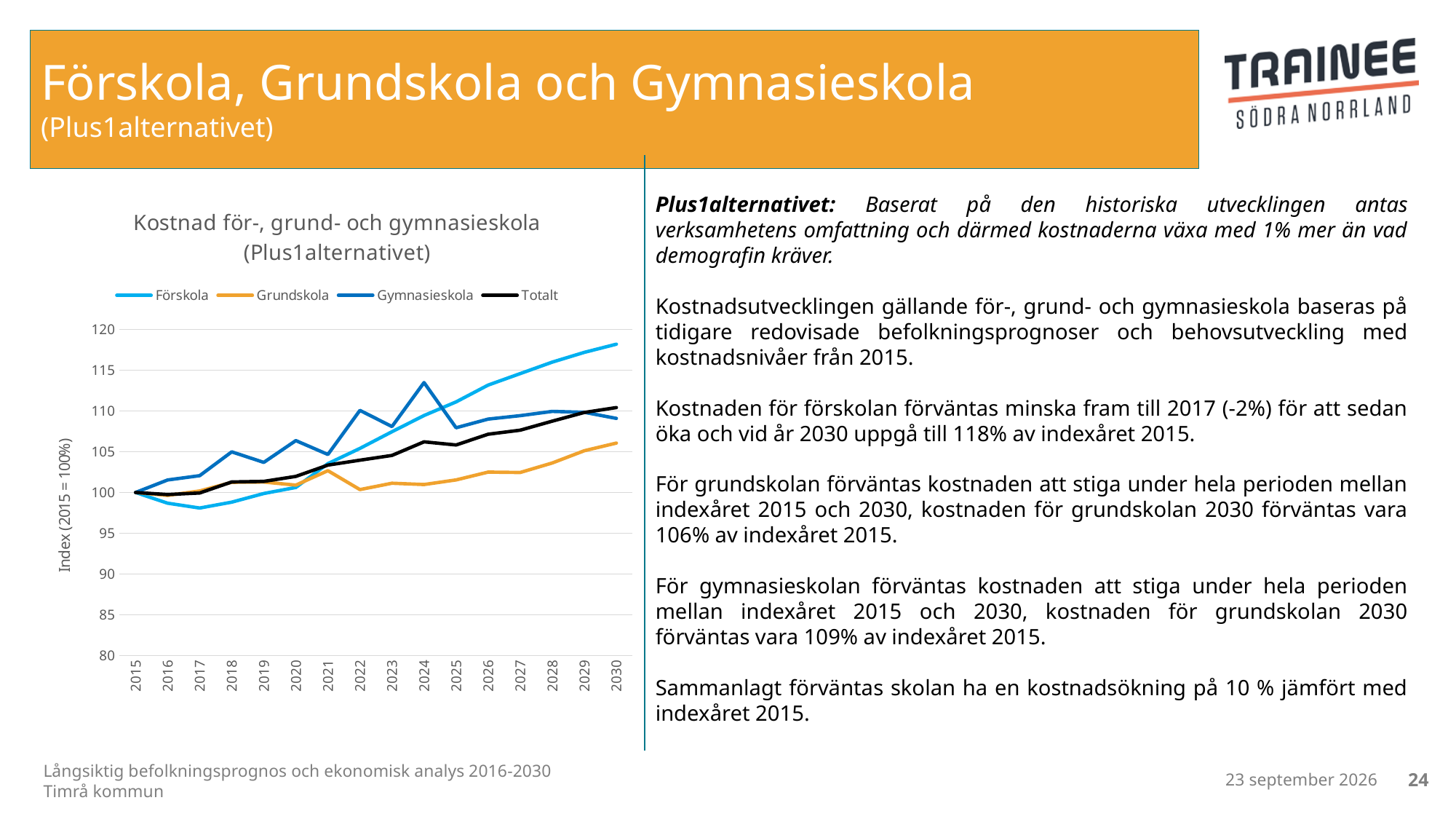
In 2018, which is larger: the value for Gymnasieskola or the value for Förskola? Gymnasieskola Which series has the lowest value in 2030? Grundskola How many series does the chart legend list? 4 What is the index value for Förskola in 2015? 100 What kind of chart is shown on the slide? Line chart What is the title of the chart? Kostnad för-, grund- och gymnasieskola (Plus1alternativet) How many years are plotted along the x axis of the chart? 16 Is the value for Förskola in 2017 greater or less than 100? less What is the index value for Totalt in 2015? 100 Is the value for Förskola in 2030 greater or less than 115? greater Is the value for Gymnasieskola in 2024 greater or less than 110? greater Which series has the highest value in 2030? Förskola